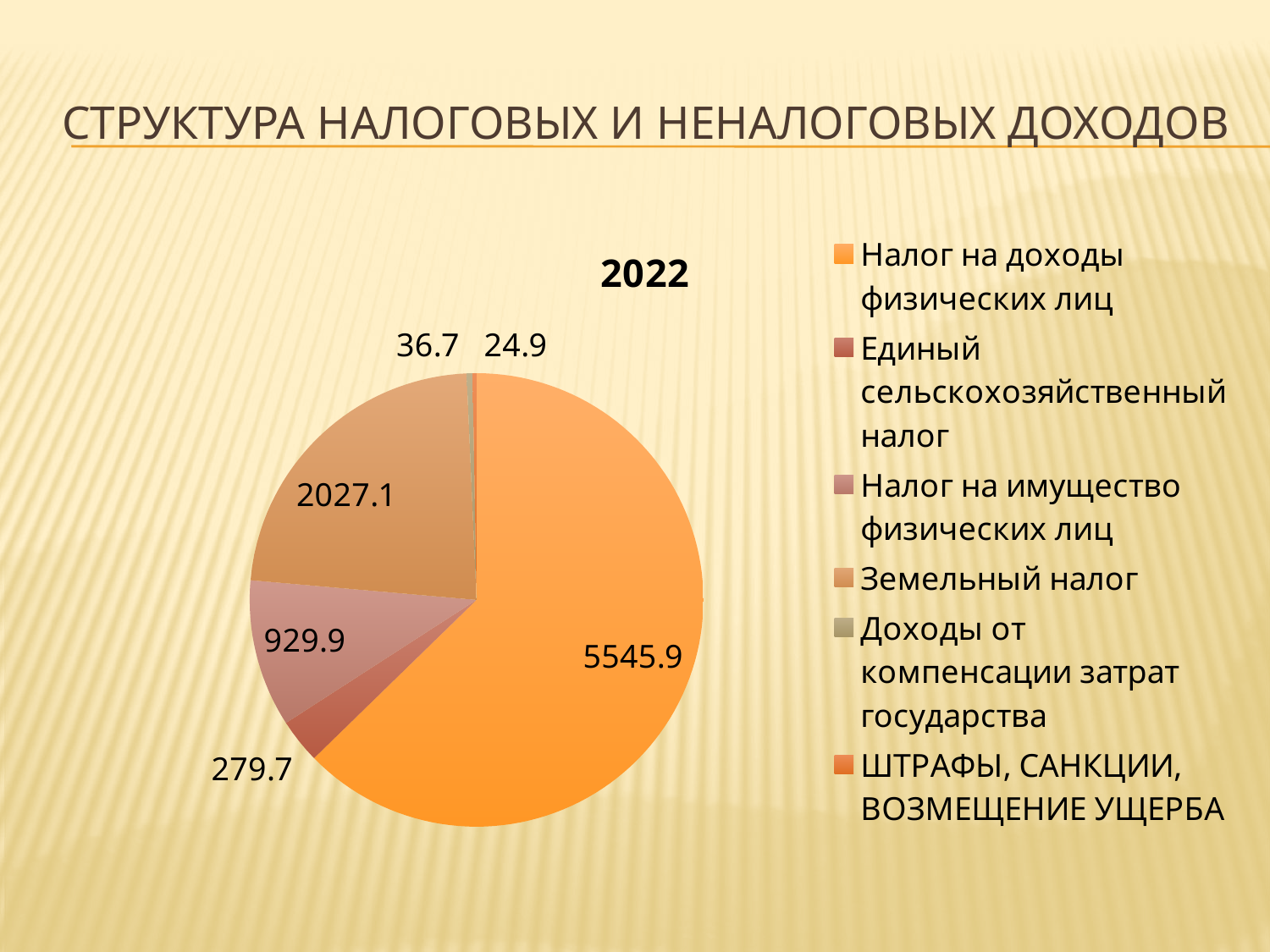
What is the value for ШТРАФЫ, САНКЦИИ, ВОЗМЕЩЕНИЕ УЩЕРБА in the 2022 pie chart? 24.9 What type of chart is shown on the slide? pie chart What is the value for Земельный налог in the 2022 pie chart? 2027.1 Which category has the smallest slice in the 2022 pie chart? ШТРАФЫ, САНКЦИИ, ВОЗМЕЩЕНИЕ УЩЕРБА What is the title shown above the pie chart? 2022 What is the value for Единый сельскохозяйственный налог in the 2022 pie chart? 279.7 What is the difference between the values for Налог на доходы физических лиц and Земельный налог? 3518.8 Which is larger: Налог на имущество физических лиц or Единый сельскохозяйственный налог? Налог на имущество физических лиц Which category has the largest slice in the 2022 pie chart? Налог на доходы физических лиц What is the value for Налог на имущество физических лиц in the 2022 pie chart? 929.9 How many categories does the legend of the pie chart list? 6 What is the value for Налог на доходы физических лиц in the 2022 pie chart? 5545.9